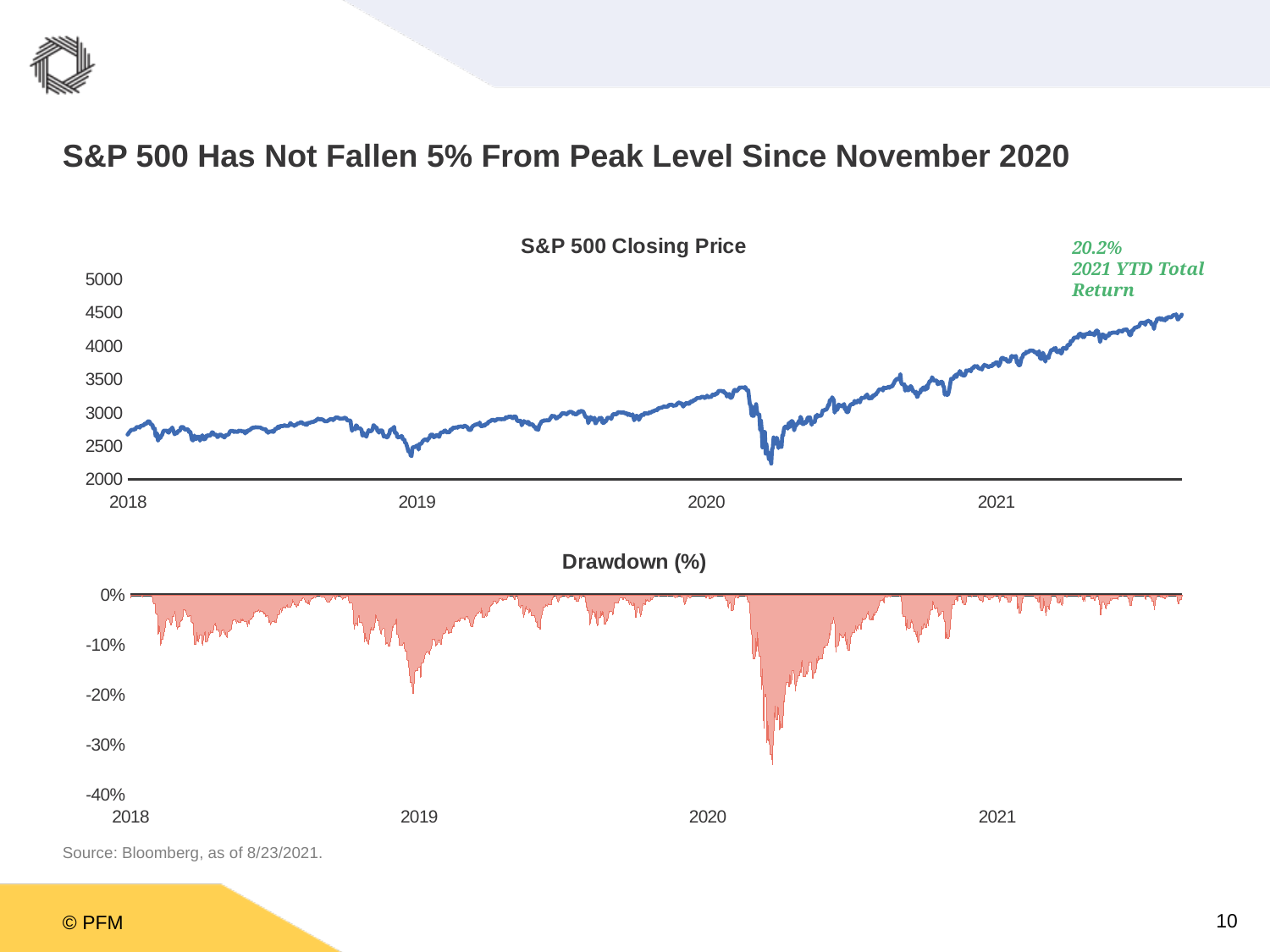
In the S&P 500 Closing Price chart, in which year does the line reach its highest level? 2021 In the S&P 500 Closing Price chart, is the value at the start of 2018 greater or less than 2500? greater In the Drawdown (%) chart, does the deepest drawdown in 2020 go below -30%? yes In the Drawdown (%) chart, in which year does the deepest drawdown occur? 2020 What 2021 YTD total return is annotated on the S&P 500 Closing Price chart? 20.2% How many year labels are shown on the x axis of the Drawdown (%) chart? 4 In the S&P 500 Closing Price chart, is the value at the end of the series in 2021 greater or less than 4000? greater In the S&P 500 Closing Price chart, do values generally rise or fall from 2018 to 2021? rise What kind of chart is the Drawdown (%) chart? area chart What kind of chart is the S&P 500 Closing Price chart? line chart